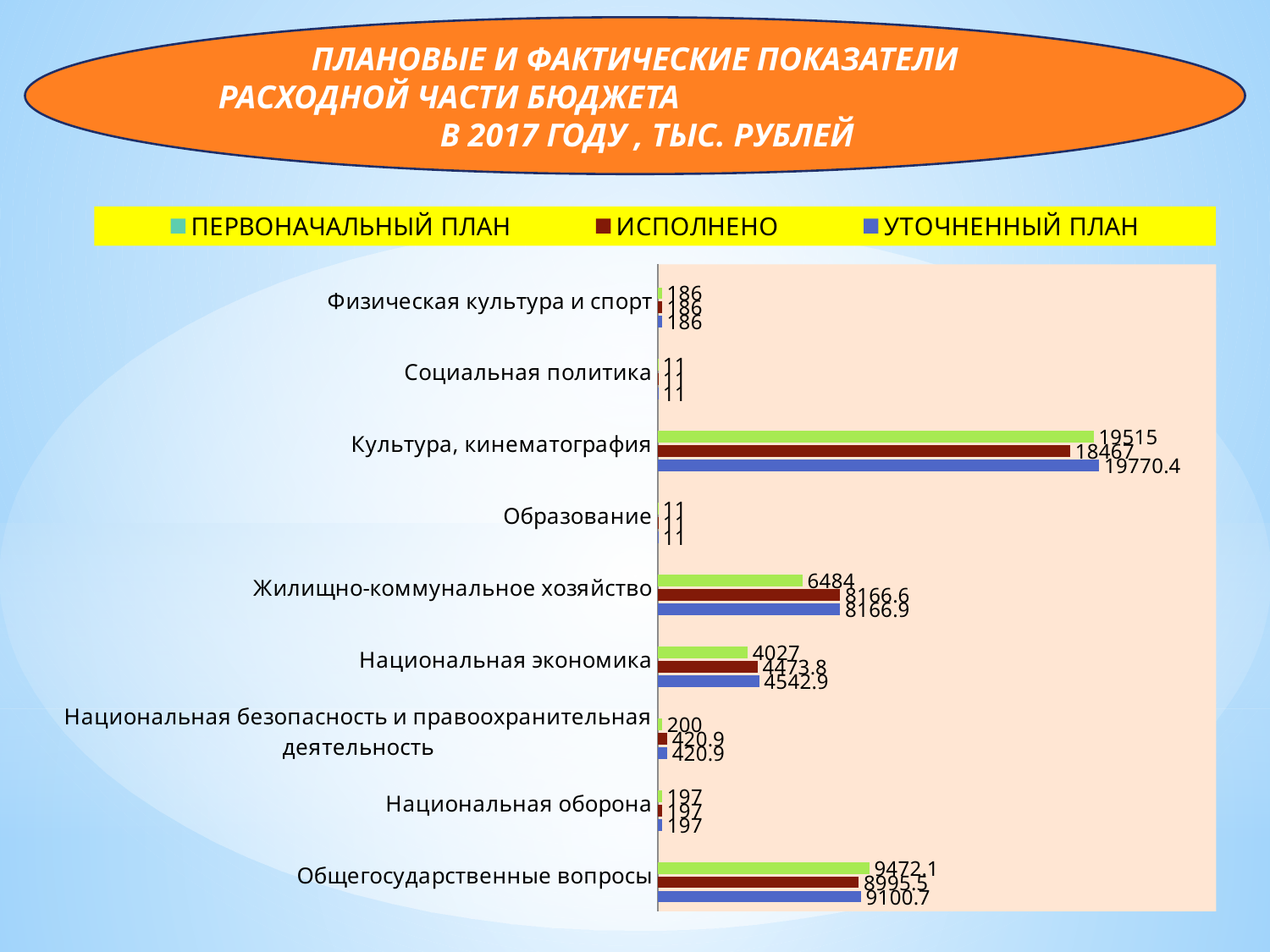
Which category has the highest ИСПОЛНЕНО value? Культура, кинематография How many series does the legend list? 3 What is the ИСПОЛНЕНО value for Национальная безопасность и правоохранительная деятельность? 420.9 Which is larger for Национальная экономика: the ПЕРВОНАЧАЛЬНЫЙ ПЛАН value or the УТОЧНЕННЫЙ ПЛАН value? УТОЧНЕННЫЙ ПЛАН What is the УТОЧНЕННЫЙ ПЛАН value for Культура, кинематография? 19770.4 What is the difference between the ПЕРВОНАЧАЛЬНЫЙ ПЛАН and ИСПОЛНЕНО values for Общегосударственные вопросы? 476.6 What type of chart is shown on the slide? Bar chart How many categories are shown on the chart? 9 What is the ИСПОЛНЕНО value for Общегосударственные вопросы? 8995.5 Which colour represents the ИСПОЛНЕНО series in the legend? Dark red What is the ПЕРВОНАЧАЛЬНЫЙ ПЛАН value for Жилищно-коммунальное хозяйство? 6484 What is the difference between the ПЕРВОНАЧАЛЬНЫЙ ПЛАН and ИСПОЛНЕНО values for Культура, кинематография? 1048